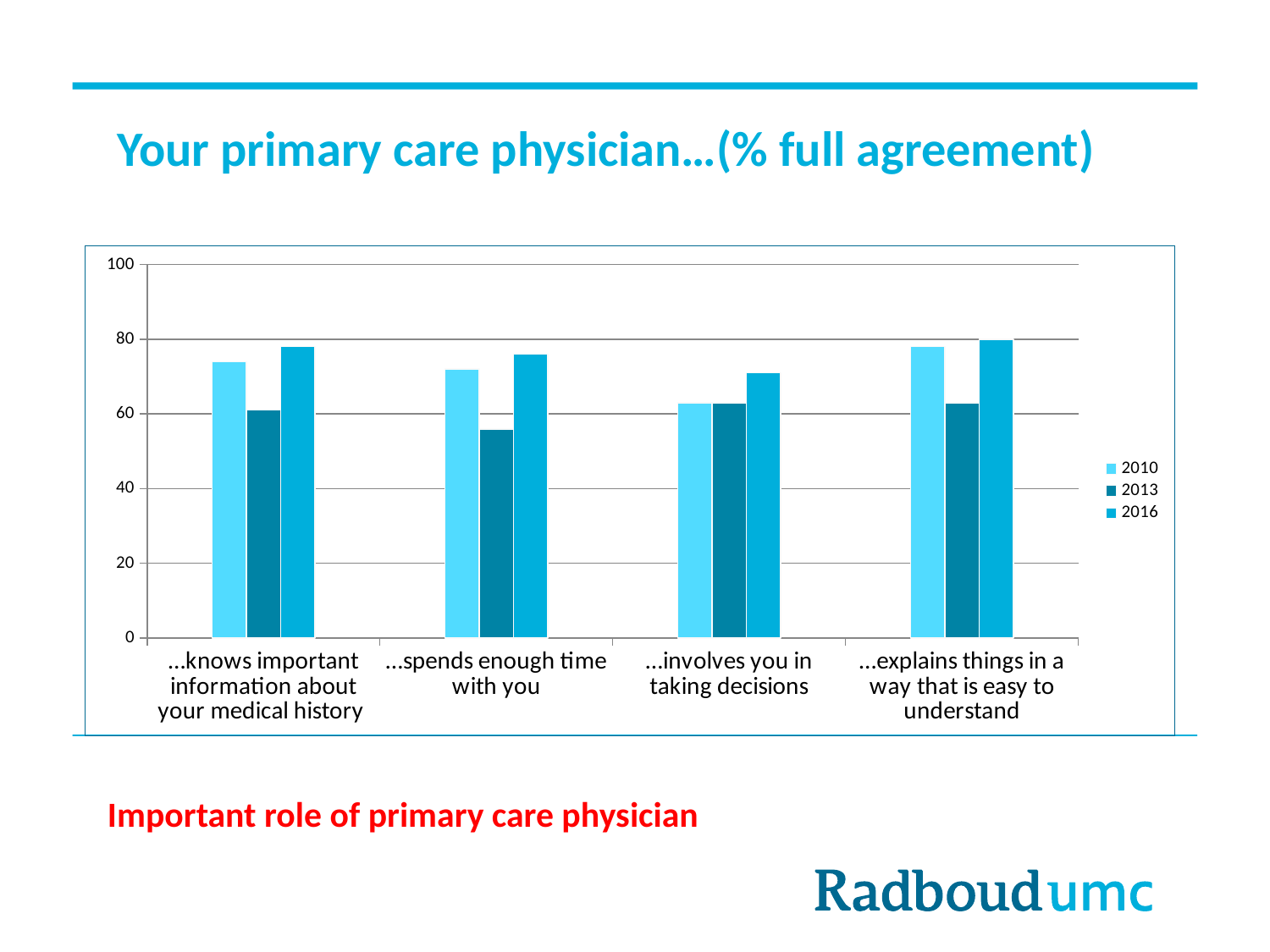
What kind of chart is shown on the slide? Bar chart Which years are listed in the legend? 2010, 2013, 2016 Is the 2013 value for '...spends enough time with you' greater or less than 60? less Is the 2010 value for '...knows important information about your medical history' greater or less than 60? greater How many series does the legend list? 3 What is the title of the chart? Your primary care physician...(% full agreement) For '...knows important information about your medical history', which is larger: the 2010 value or the 2013 value? 2010 Which category has the lowest 2013 value? ...spends enough time with you For '...spends enough time with you', which is larger: the 2013 value or the 2016 value? 2016 How many categories are shown on the x axis? 4 For '...explains things in a way that is easy to understand', how does the value change from 2010 to 2013 to 2016? Falls from 2010 to 2013, then rises in 2016 Is the 2016 value for '...involves you in taking decisions' greater or less than 80? less